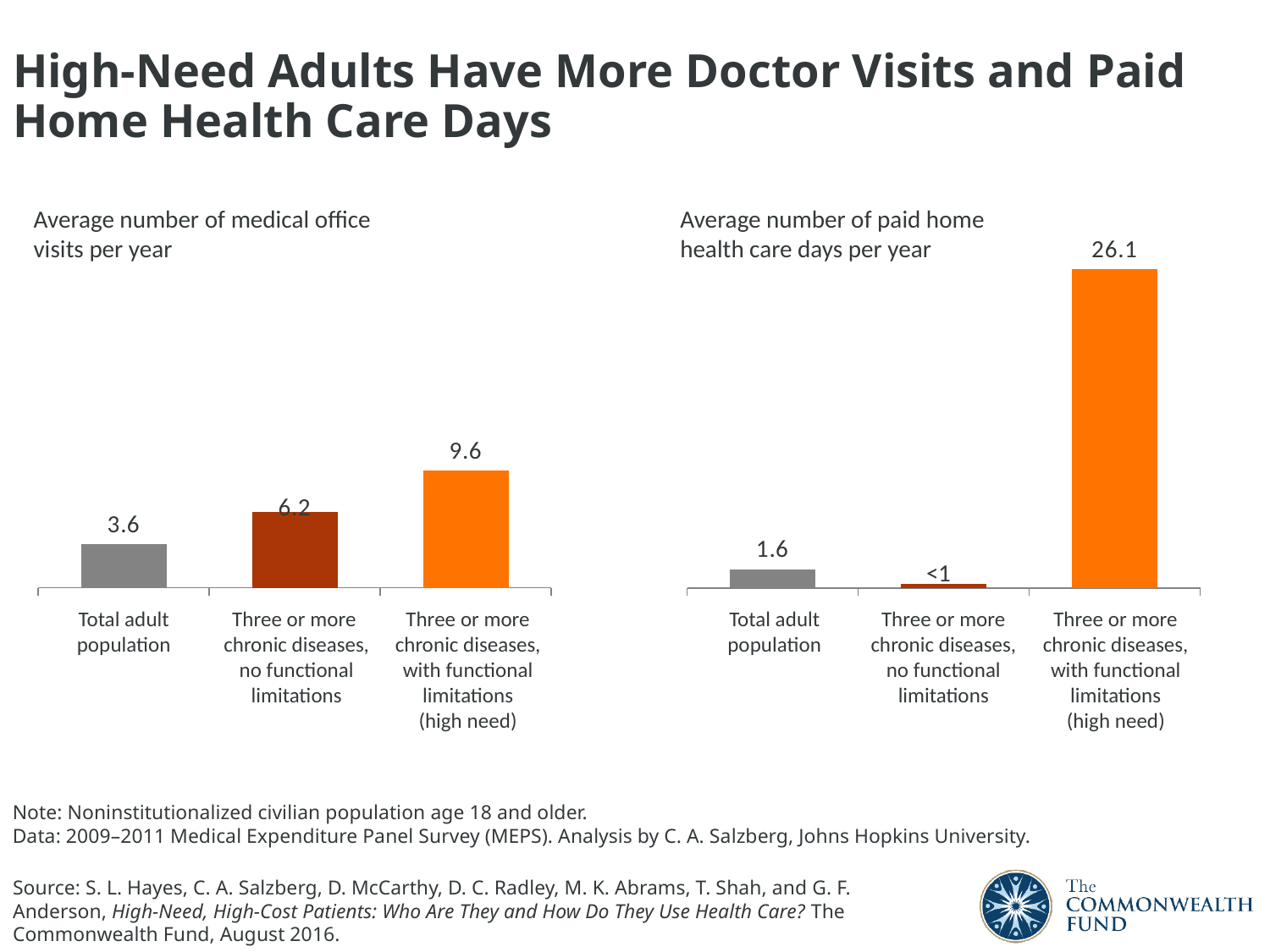
In the left chart (average number of medical office visits per year), which is larger: the value for the total adult population or the value for three or more chronic diseases with no functional limitations? Three or more chronic diseases, no functional limitations How many categories are shown in the right chart (average number of paid home health care days per year)? 3 In the right chart (average number of paid home health care days per year), which category has the lowest value? Three or more chronic diseases, no functional limitations In the left chart (average number of medical office visits per year), what is the value for adults with three or more chronic diseases and no functional limitations? 6.2 In the left chart (average number of medical office visits per year), what is the value for the total adult population? 3.6 In the left chart (average number of medical office visits per year), what is the value for the high-need group (three or more chronic diseases with functional limitations)? 9.6 In the right chart (average number of paid home health care days per year), what is the value for the high-need group? 26.1 What type of chart is the left chart (average number of medical office visits per year)? Bar chart In the right chart (average number of paid home health care days per year), what label is shown for adults with three or more chronic diseases and no functional limitations? <1 In the left chart (average number of medical office visits per year), what is the difference between the high-need group and the total adult population? 6.0 In the left chart (average number of medical office visits per year), which category has the highest value? Three or more chronic diseases, with functional limitations (high need) In the right chart (average number of paid home health care days per year), what is the value for the total adult population? 1.6